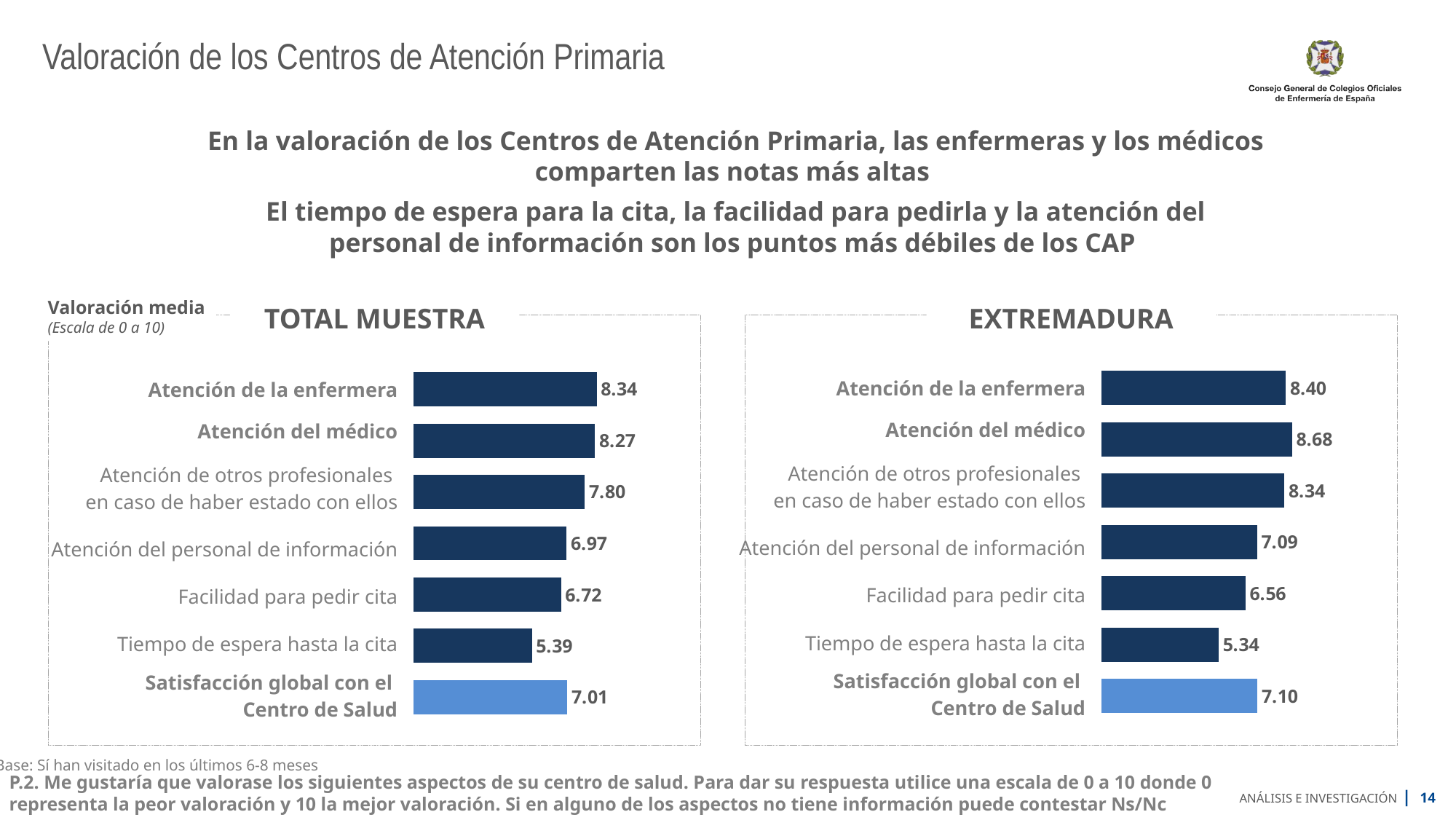
In the EXTREMADURA chart, what is the value for Atención del médico? 8.68 In the TOTAL MUESTRA chart, what is the value for Satisfacción global con el Centro de Salud? 7.01 In the TOTAL MUESTRA chart, which category has the lowest value? Tiempo de espera hasta la cita In the EXTREMADURA chart, what is the difference between Atención del personal de información and Facilidad para pedir cita? 0.53 Which is larger: Facilidad para pedir cita in the TOTAL MUESTRA chart or in the EXTREMADURA chart? TOTAL MUESTRA In the TOTAL MUESTRA chart, what is the difference between Atención de la enfermera and Atención del médico? 0.07 In the EXTREMADURA chart, what is the value for Tiempo de espera hasta la cita? 5.34 In the TOTAL MUESTRA chart, which category's bar is shown in a lighter blue than the others? Satisfacción global con el Centro de Salud In the EXTREMADURA chart, which category has the highest value? Atención del médico What kind of chart is the EXTREMADURA chart? Bar chart How many categories are shown in the TOTAL MUESTRA chart? 7 In the TOTAL MUESTRA chart, what is the value for Atención de la enfermera? 8.34